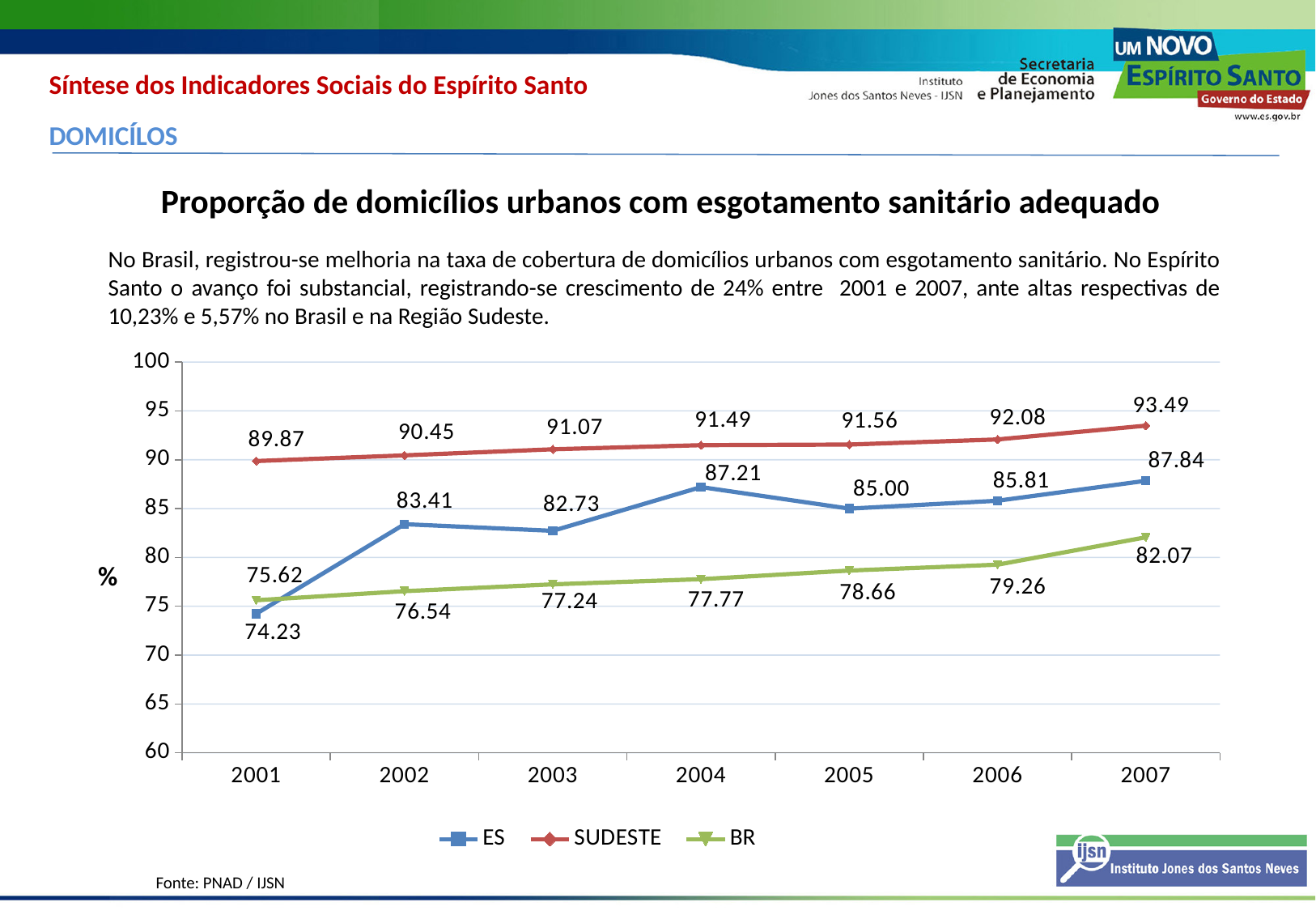
What is the difference between the ES value in 2007 and the ES value in 2001? 13.61 What is the value for ES in 2001? 74.23 Which series is drawn in red? SUDESTE What is the value for BR in 2005? 78.66 Does the SUDESTE series rise or fall from 2001 to 2007? rise In which year is the ES series at its lowest? 2001 In which year is the BR series at its highest? 2007 Which is larger in 2004, the ES value or the BR value? ES How many years are shown on the x axis? 7 How many series does the legend list? 3 What is the value for SUDESTE in 2007? 93.49 What type of chart is shown on the slide? line chart